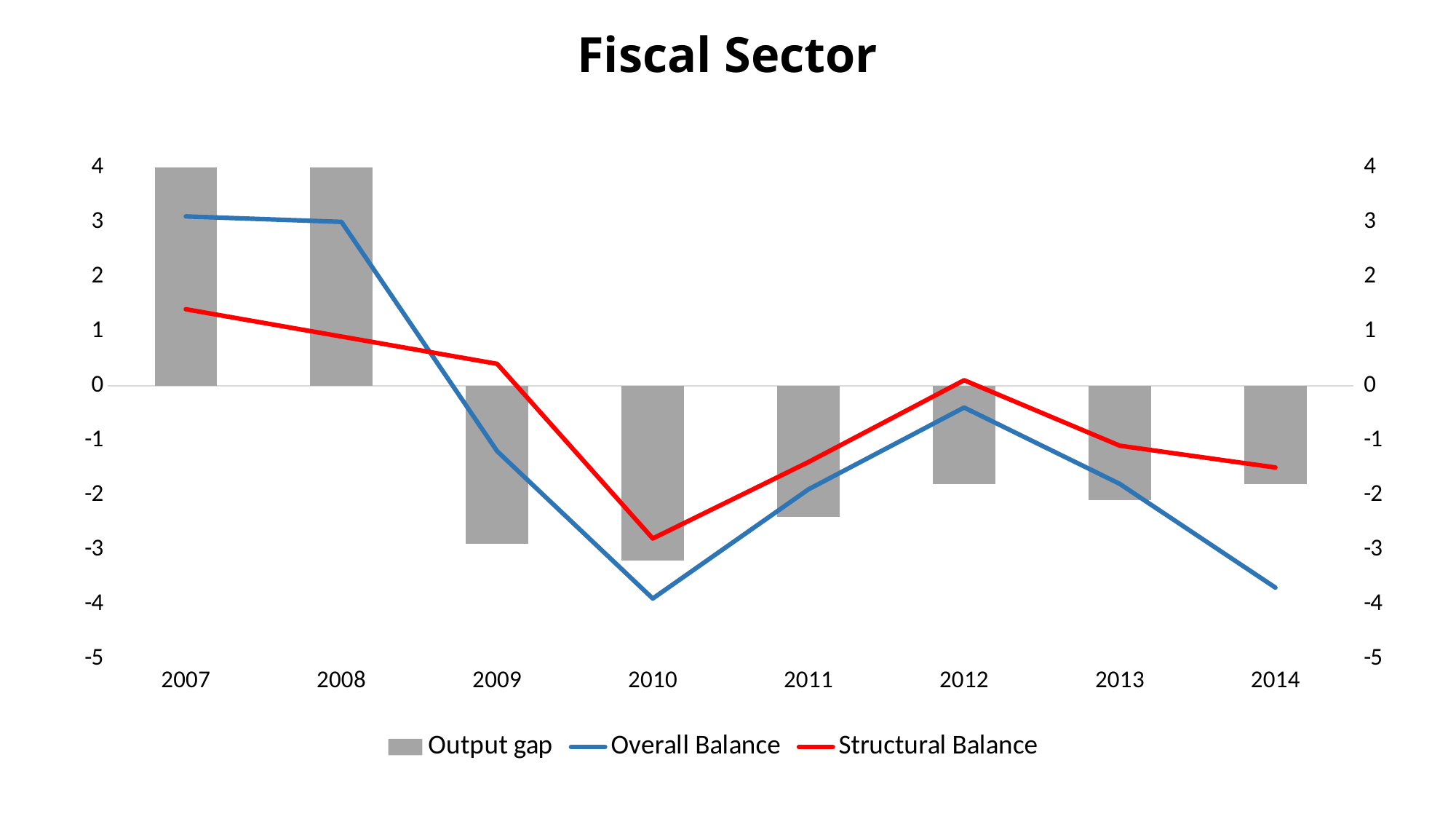
Is the Structural Balance value for 2007 greater or less than 1? greater What kind of chart is this? Combination bar and line chart Is the Output gap value for 2009 greater or less than -2? less In which year is the Structural Balance lowest? 2010 How many years are shown on the x axis? 8 How many series does the legend list? 3 What colour is the Structural Balance line? Red Is the Overall Balance value for 2010 greater or less than -3? less In 2010, which is larger, the Overall Balance or the Structural Balance? Structural Balance What is the title of the chart? Fiscal Sector In which year is the Structural Balance highest? 2007